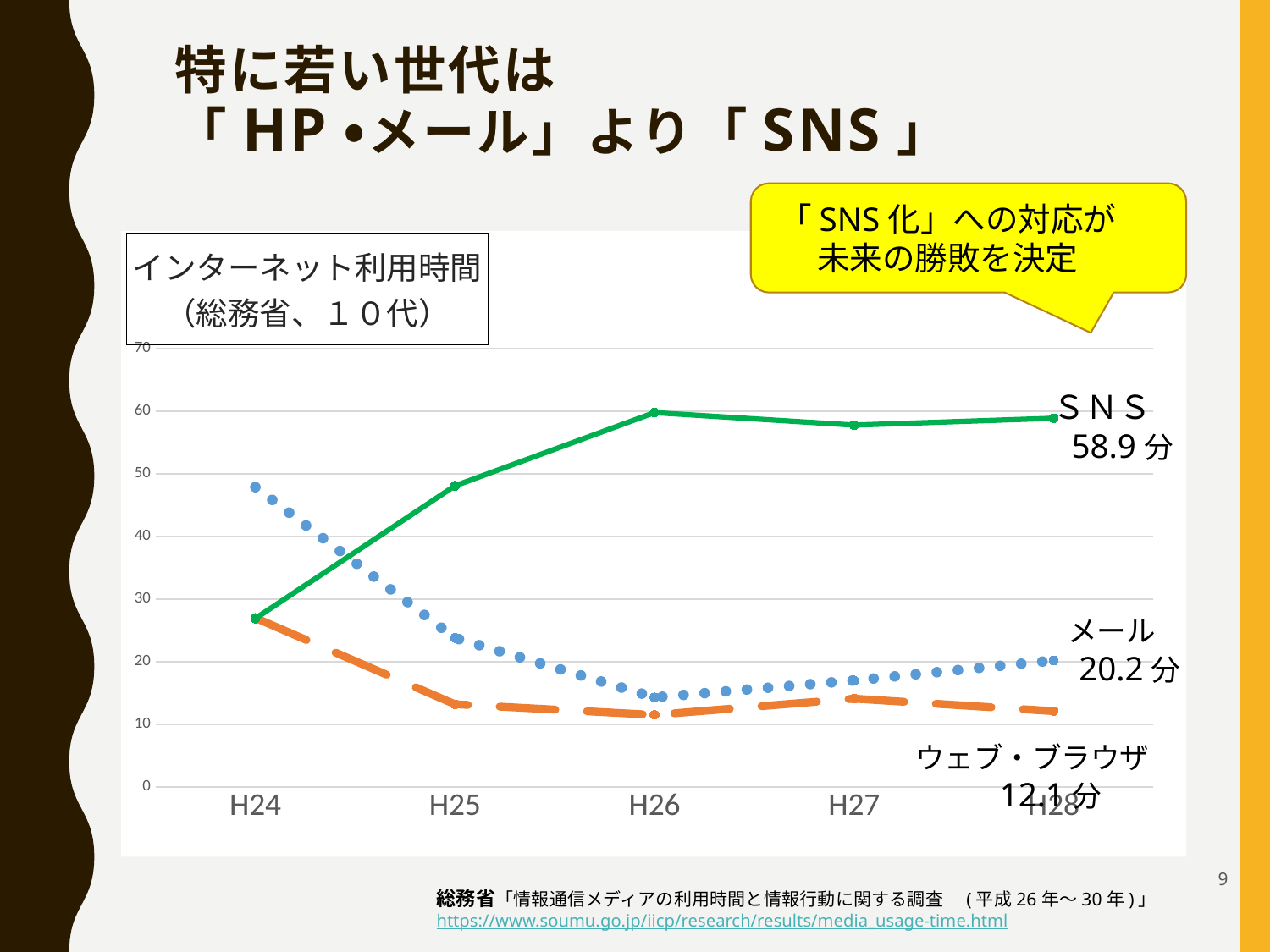
How many lines (series) are plotted on the chart? 3 What is the title of the chart? インターネット利用時間（総務省、10代） What kind of chart is shown on the slide? Line chart Which series has the highest value at H28? SNS Which series has the lowest value at H28? ウェブ・ブラウザ What is the value for ウェブ・ブラウザ at H28? 12.1分 Is the value for SNS at H24 greater or less than 30? less How many years are shown along the x axis of the chart? 5 What is the value for SNS at H28? 58.9分 What is the value for メール at H28? 20.2分 What is the difference between the SNS value and the メール value at H28? 38.7分 Does the SNS line rise or fall from H24 to H28? rise